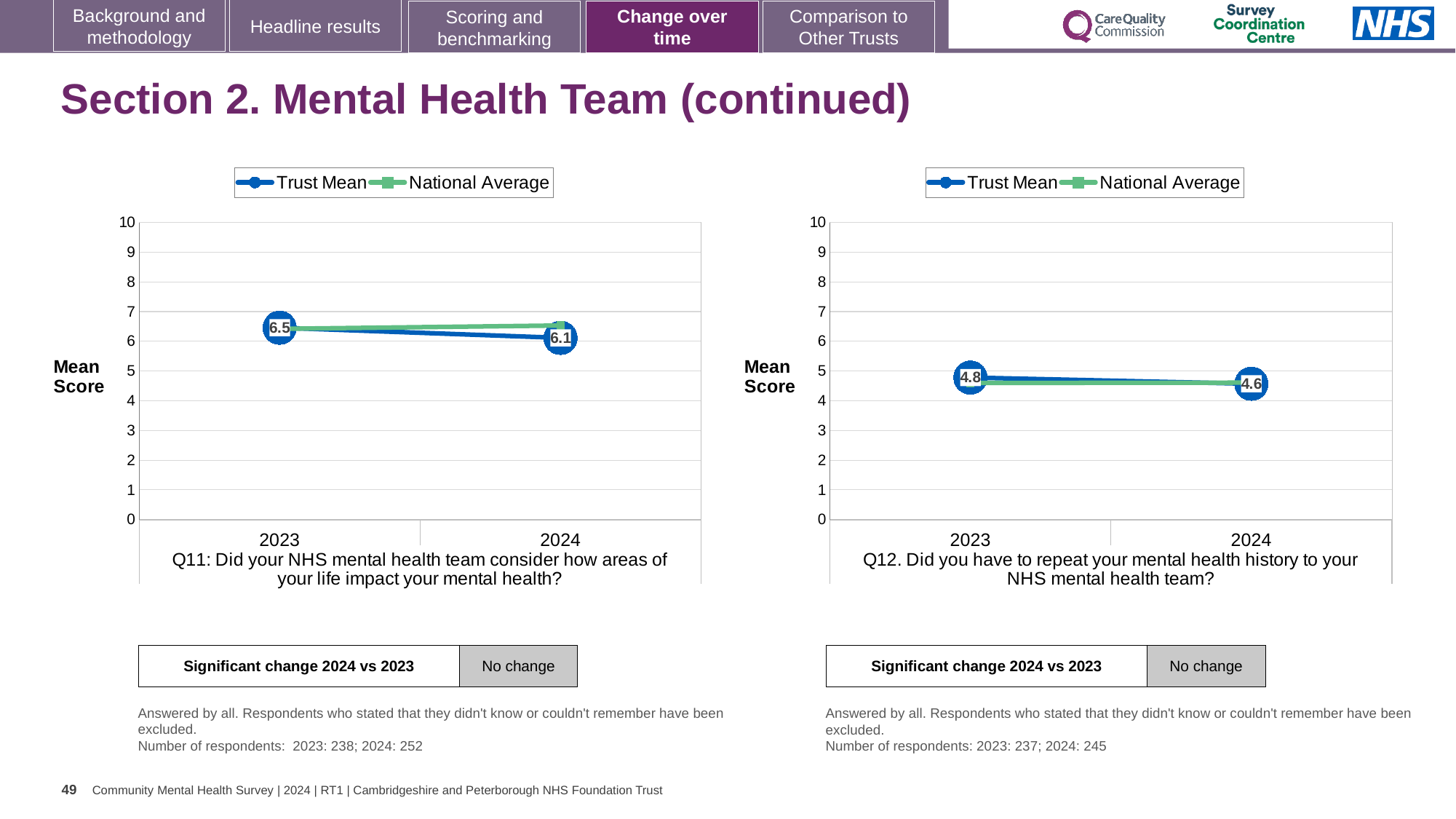
In the Q12 chart on the right, what is the Trust Mean score for 2024? 4.6 What type of chart is used for Q11 on the left? line chart In the Q12 chart on the right, what is the difference between the Trust Mean in 2023 and 2024? 0.2 In the Q11 chart on the left, what is the Trust Mean score for 2023? 6.5 How many series does the legend of the Q12 chart on the right list? 2 In the Q12 chart on the right, is the Trust Mean for 2023 greater or less than 5? less In the Q11 chart on the left, what is the Trust Mean score for 2024? 6.1 In the Q11 chart on the left, does the Trust Mean rise or fall from 2023 to 2024? fall In the Q12 chart on the right, what is the Trust Mean score for 2023? 4.8 In the Q11 chart on the left, by how much did the Trust Mean fall from 2023 to 2024? 0.4 In the Q11 chart on the left, is the Trust Mean for 2023 greater or less than 6? greater How many years are plotted on the x axis of the Q11 chart on the left? 2